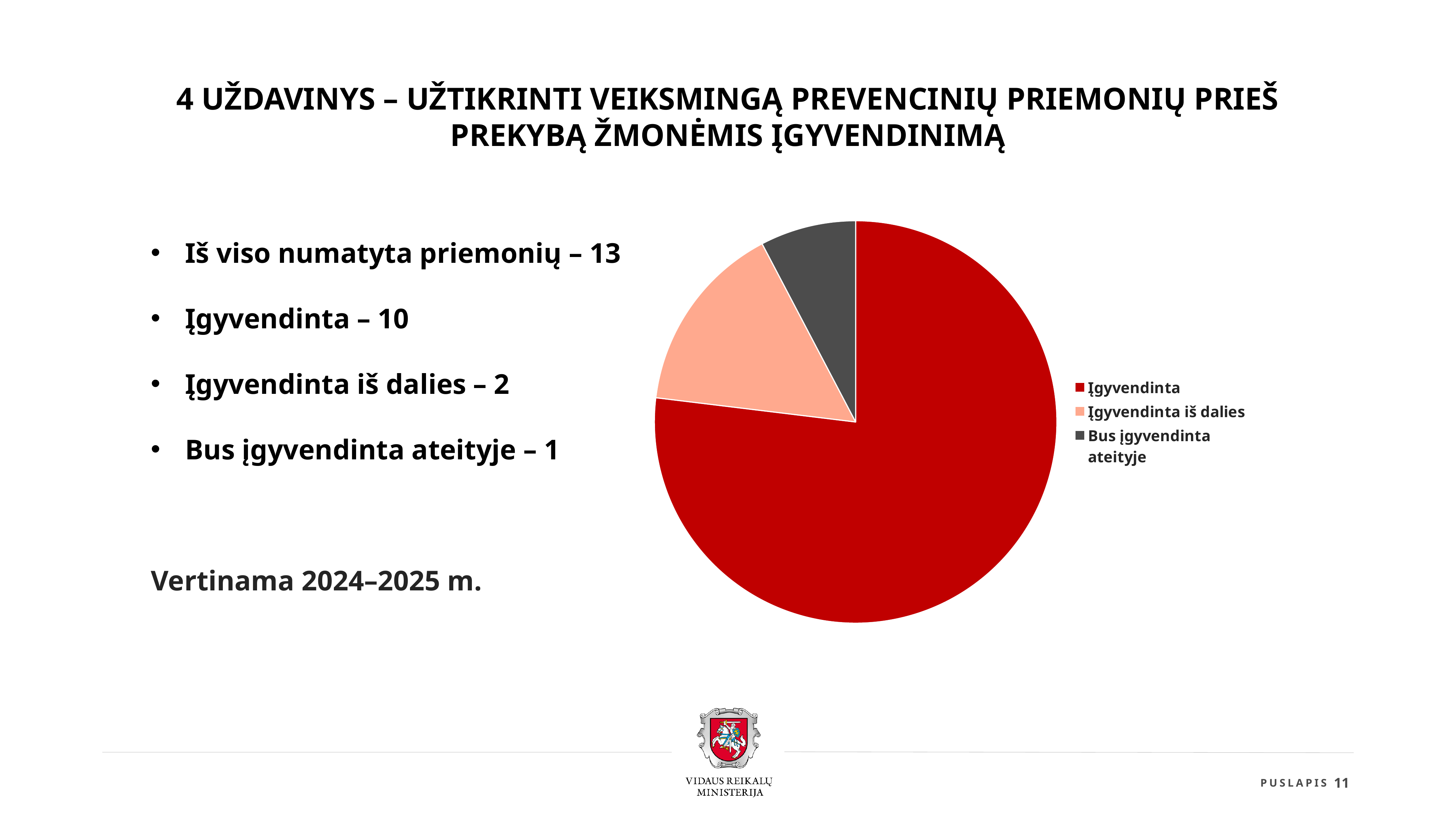
What is the total number of measures represented in the pie chart? 13 According to the slide, how many measures are in the Įgyvendinta category? 10 Which category has the largest slice in the pie chart? Įgyvendinta According to the slide, how many measures are in the Bus įgyvendinta ateityje category? 1 How many entries does the legend of the pie chart list? 3 How many slices does the pie chart have? 3 According to the slide, how many measures are in the Įgyvendinta iš dalies category? 2 What colour is the Įgyvendinta slice in the pie chart? red Which slice is larger: Įgyvendinta iš dalies or Bus įgyvendinta ateityje? Įgyvendinta iš dalies What kind of chart is shown on the slide? pie chart Which category has the smallest slice in the pie chart? Bus įgyvendinta ateityje What is the difference between the number of Įgyvendinta measures and the number of Įgyvendinta iš dalies measures? 8